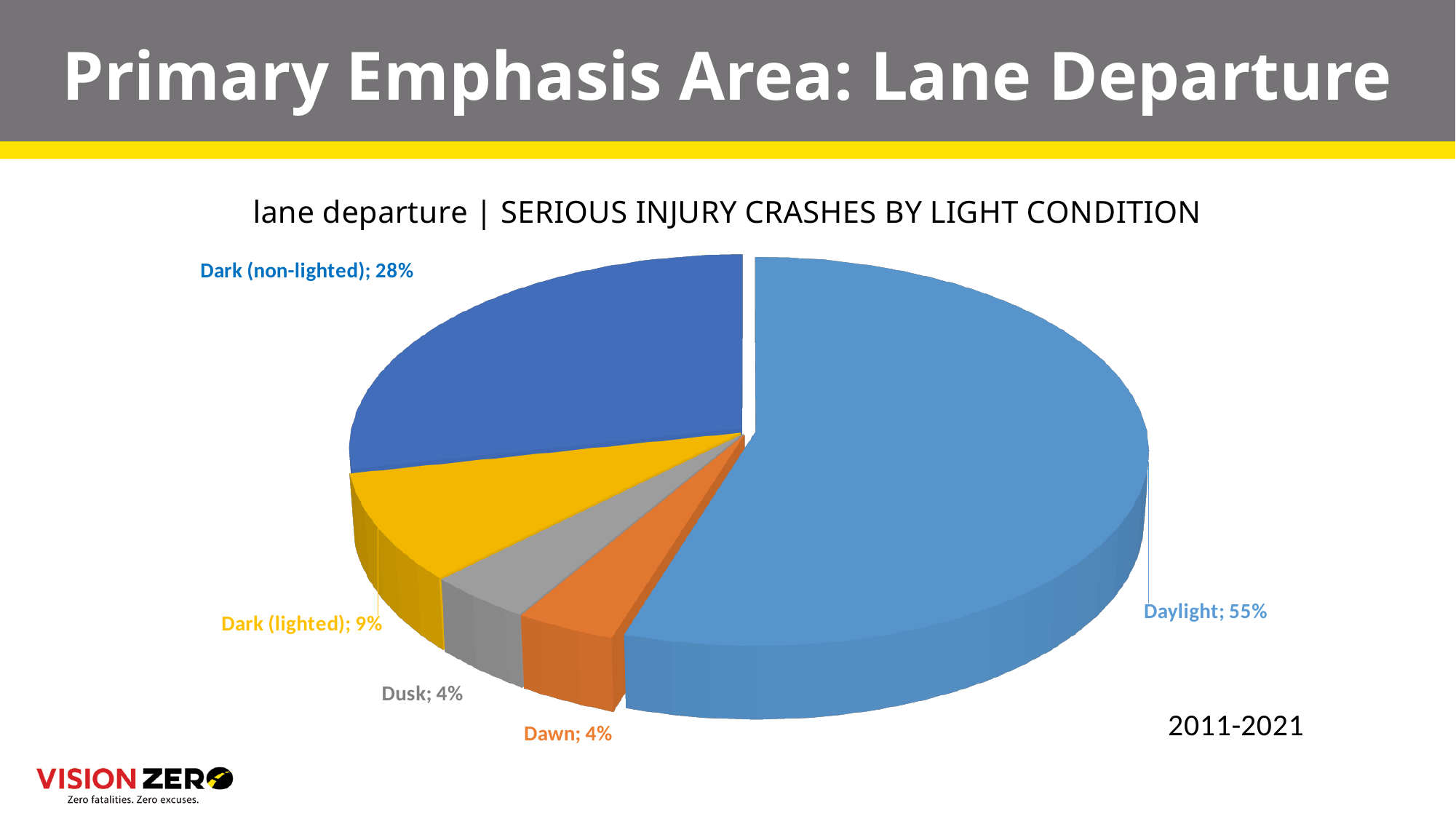
What is the difference in percentage points between the Daylight and Dark (non-lighted) shares? 27 What kind of chart is shown on the slide? Pie chart What share of lane departure serious injury crashes occurred in Dark (lighted) conditions? 9% What year range is shown for the chart data? 2011-2021 What is the combined share of the Dark (non-lighted) and Dark (lighted) slices? 37% Which light condition has the largest share of lane departure serious injury crashes? Daylight What share of lane departure serious injury crashes occurred at Dusk? 4% What share of lane departure serious injury crashes occurred in Dark (non-lighted) conditions? 28% What is the title of the chart? lane departure | SERIOUS INJURY CRASHES BY LIGHT CONDITION How many light condition categories are shown in the pie chart? 5 Which is larger, the share for Dark (lighted) or the share for Dawn? Dark (lighted) What share of lane departure serious injury crashes occurred in Daylight? 55%